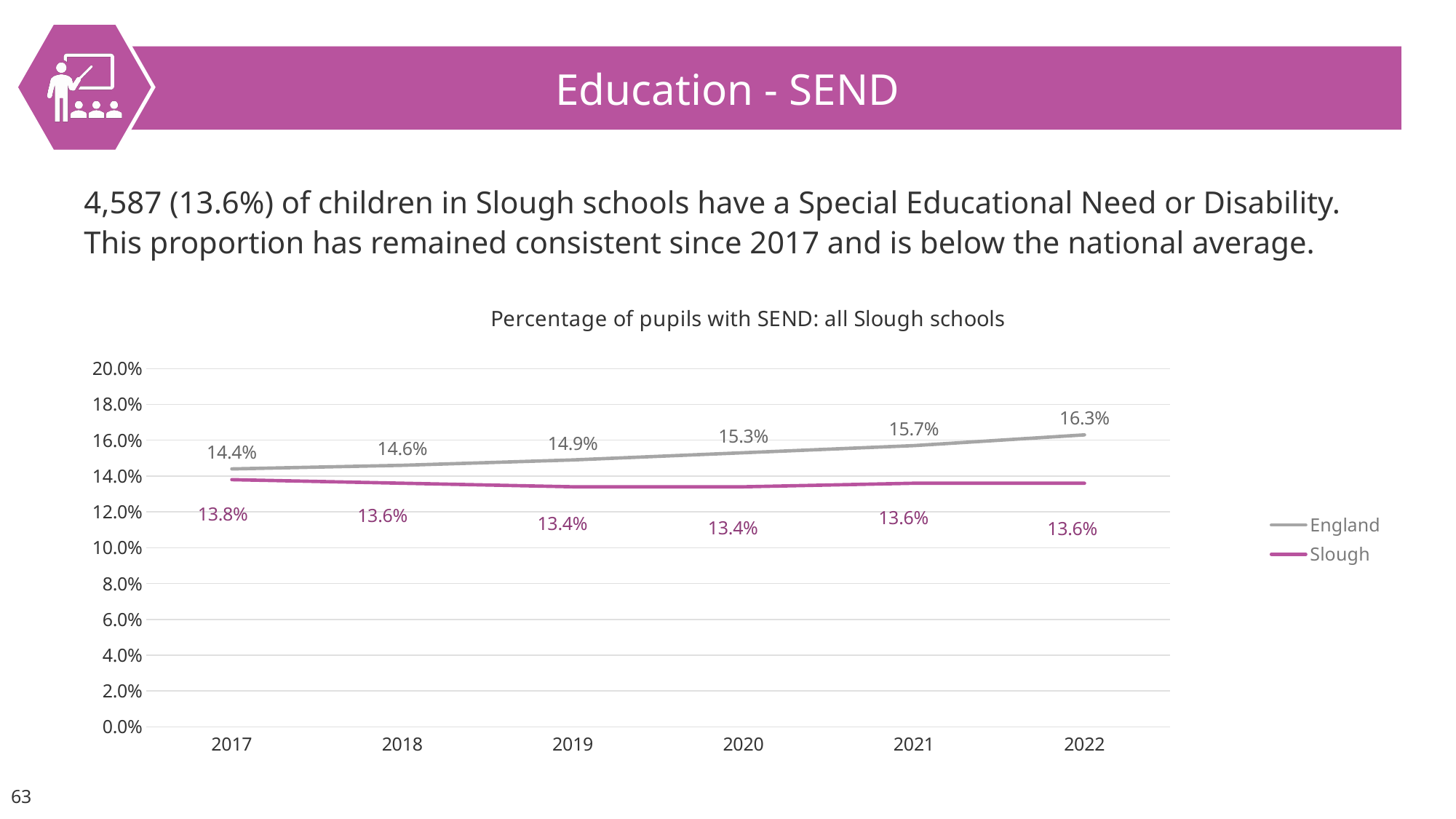
What is the Slough value for 2020? 13.4% What is the England value for 2019? 14.9% What kind of chart is this? Line chart In which year is the Slough series highest? 2017 Which series has the larger value in 2021, England or Slough? England How many series does the legend list? 2 Does the England series rise or fall from 2017 to 2022? Rise In which year is the England series highest? 2022 How many years are shown on the x axis? 6 What is the England value for 2022? 16.3% What is the difference between the England and Slough values in 2022? 2.7% What is the Slough value for 2017? 13.8%